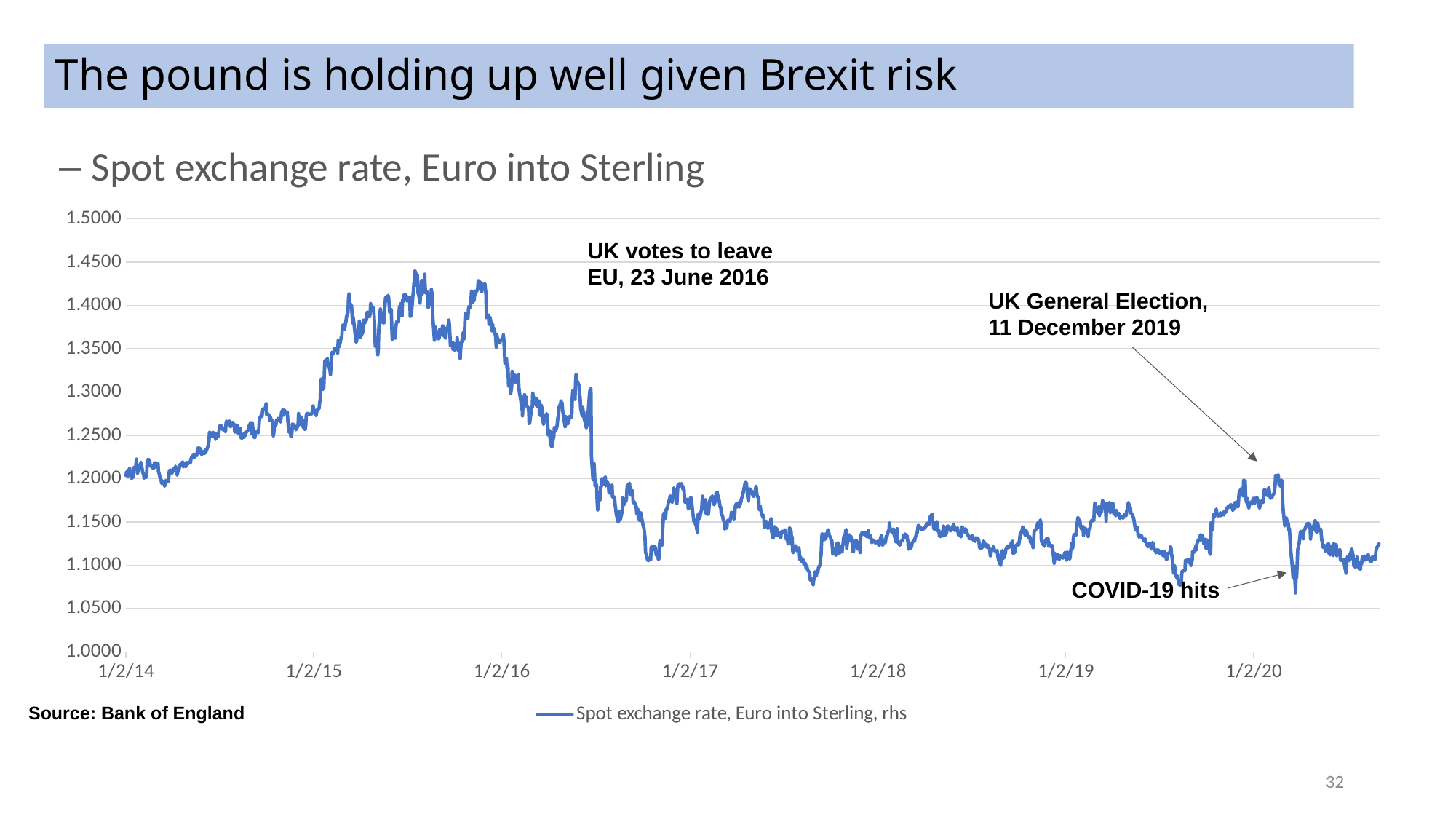
Does the exchange rate rise or fall immediately after the 'UK votes to leave EU' line in June 2016? fall According to the annotation on the chart, on what date did the UK vote to leave the EU? 23 June 2016 Is the exchange rate at 1/2/18 greater or less than 1.2000? less Is the exchange rate at 1/2/14 greater or less than 1.2500? less How many date labels are shown on the x axis? 7 Is the lowest point of the exchange rate around the 'COVID-19 hits' annotation greater or less than 1.1000? less How many series does the legend list? 1 What is the name of the series shown in the legend? Spot exchange rate, Euro into Sterling, rhs Does the exchange rate rise or fall between 1/2/14 and 1/2/15? rise What kind of chart is shown on the slide? Line chart